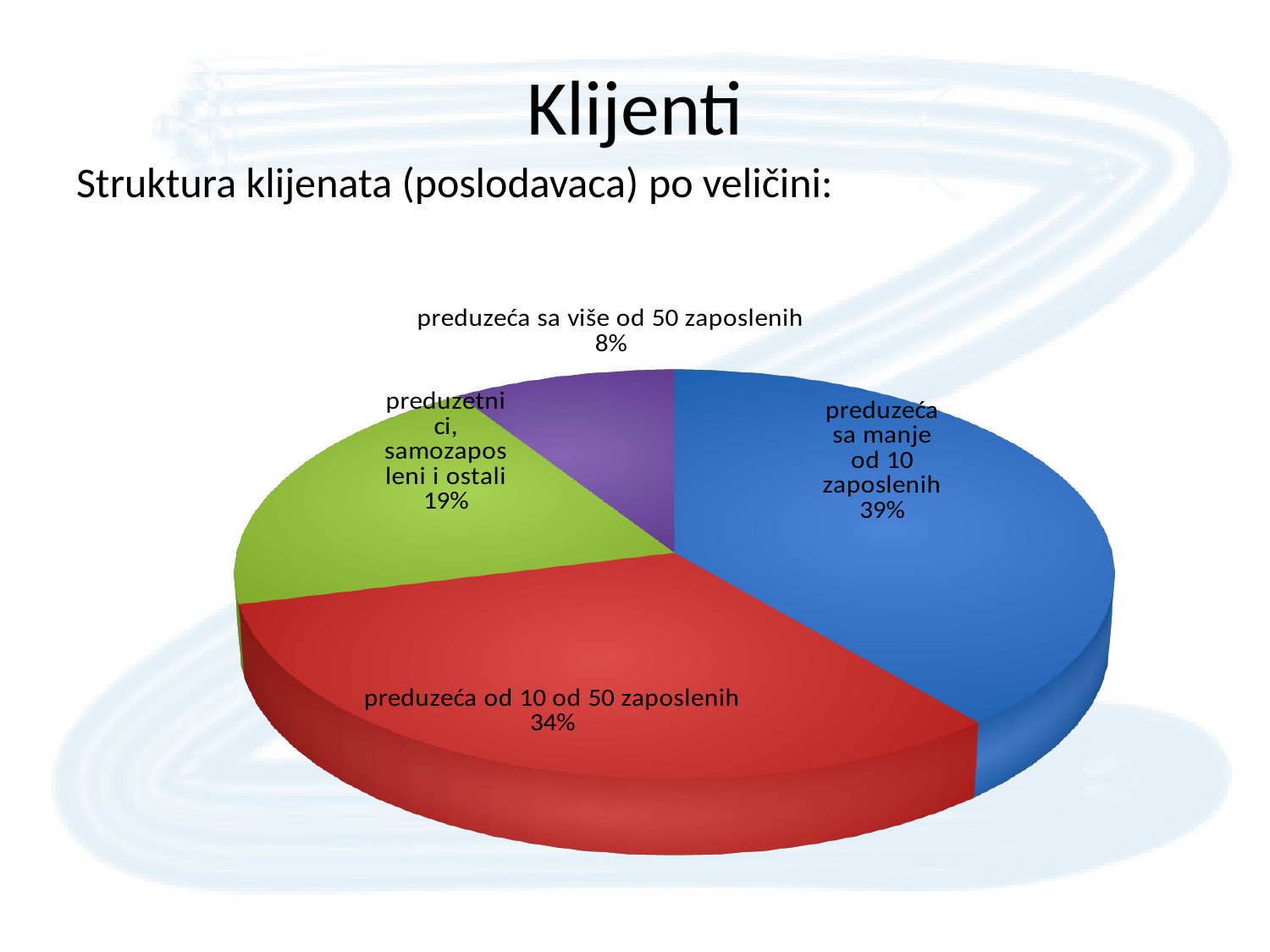
Which is larger: the share for 'preduzetnici, samozaposleni i ostali' or the share for 'preduzeća sa više od 50 zaposlenih'? preduzetnici, samozaposleni i ostali What is the difference in percentage points between 'preduzeća sa manje od 10 zaposlenih' and 'preduzeća od 10 od 50 zaposlenih'? 5 percentage points What share of clients are 'preduzeća sa više od 50 zaposlenih'? 8% What share of clients are 'preduzetnici, samozaposleni i ostali'? 19% How many categories (slices) does the pie chart have? 4 Which category has the smallest share of the pie? preduzeća sa više od 50 zaposlenih What share of clients are 'preduzeća od 10 od 50 zaposlenih'? 34% Which category has the largest share of the pie? preduzeća sa manje od 10 zaposlenih What kind of chart is shown on the slide? pie chart What colour is the slice for 'preduzeća od 10 od 50 zaposlenih'? red What share of clients are 'preduzeća sa manje od 10 zaposlenih'? 39% What is the combined share of 'preduzeća sa manje od 10 zaposlenih' and 'preduzeća od 10 od 50 zaposlenih'? 73%